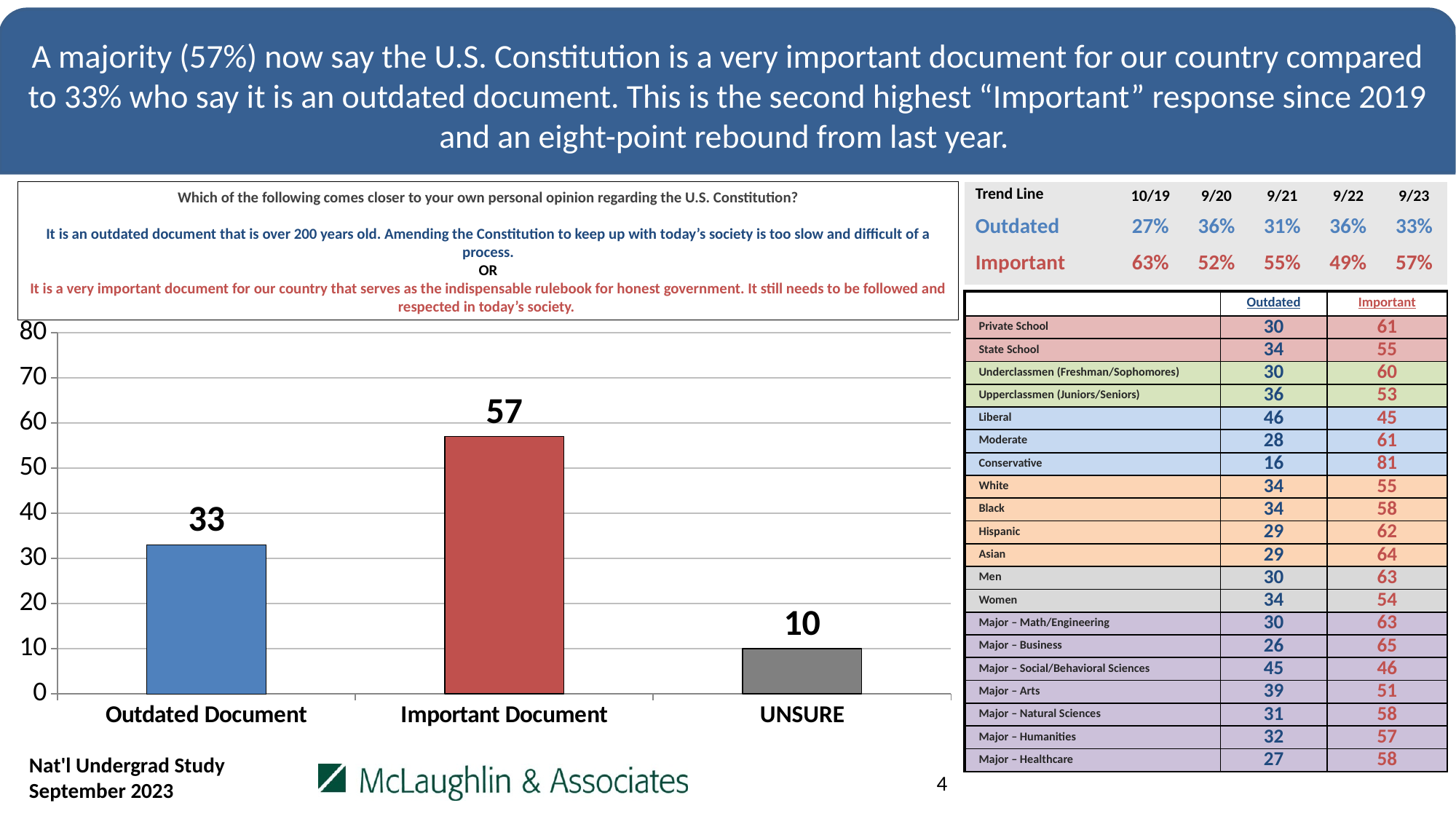
What is the value for UNSURE? 10 What is the value for Outdated Document? 33 How many categories are shown on the x axis of the chart? 3 Which category has the lowest value? UNSURE What colour is the bar for Important Document? red What is the value for Important Document? 57 Which is larger, the value for Outdated Document or the value for UNSURE? Outdated Document Which category has the highest value? Important Document What is the highest value shown on the chart's y axis? 80 What kind of chart is shown on the slide? bar chart What is the difference between the values for Important Document and Outdated Document? 24 Is the value for Important Document greater or less than 50? greater